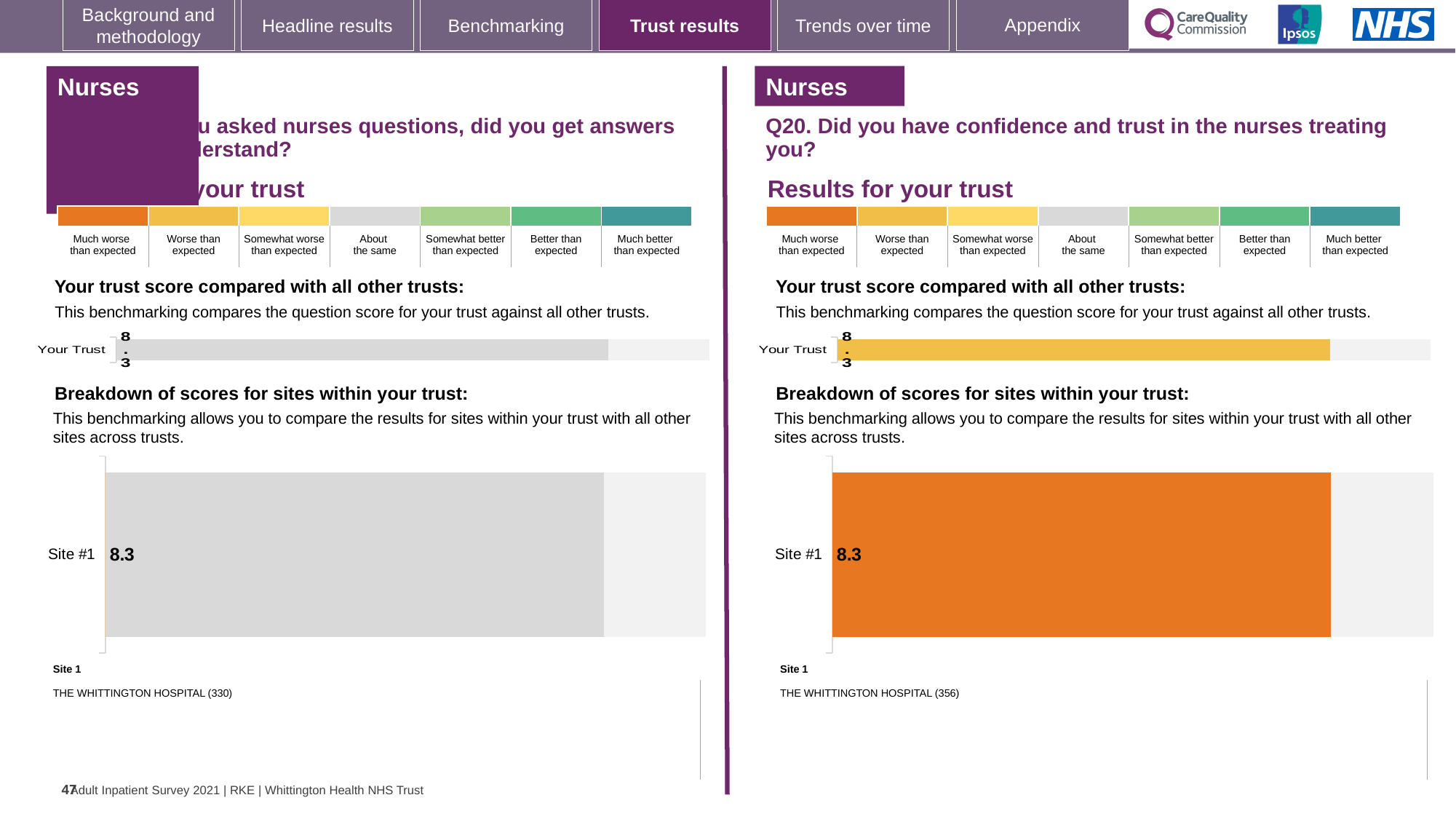
Which site is listed as Site 1 on the left-hand chart? THE WHITTINGTON HOSPITAL (330) What kind of chart is used to show the Site #1 score on the right-hand side of the slide? Bar chart How many sites are shown in the breakdown of scores on the right-hand chart for Q20? 1 On the right-hand chart for Q20 (confidence and trust in nurses), what is the score shown for Your Trust? 8.3 On the right-hand chart for Q20, is the Your Trust score greater or less than 8? greater On the left-hand chart (nurses question), what is the score shown for Site #1? 8.3 Which site is listed as Site 1 on the right-hand chart for Q20? THE WHITTINGTON HOSPITAL (356) On the left-hand chart (nurses question), what is the score shown for Your Trust? 8.3 How many sites are shown in the breakdown of scores on the left-hand chart? 1 On the right-hand chart for Q20, what is the score shown for Site #1? 8.3 On the right-hand chart for Q20, what colour is the Site #1 bar? Orange On the right-hand chart for Q20, what colour is the Your Trust bar? Yellow